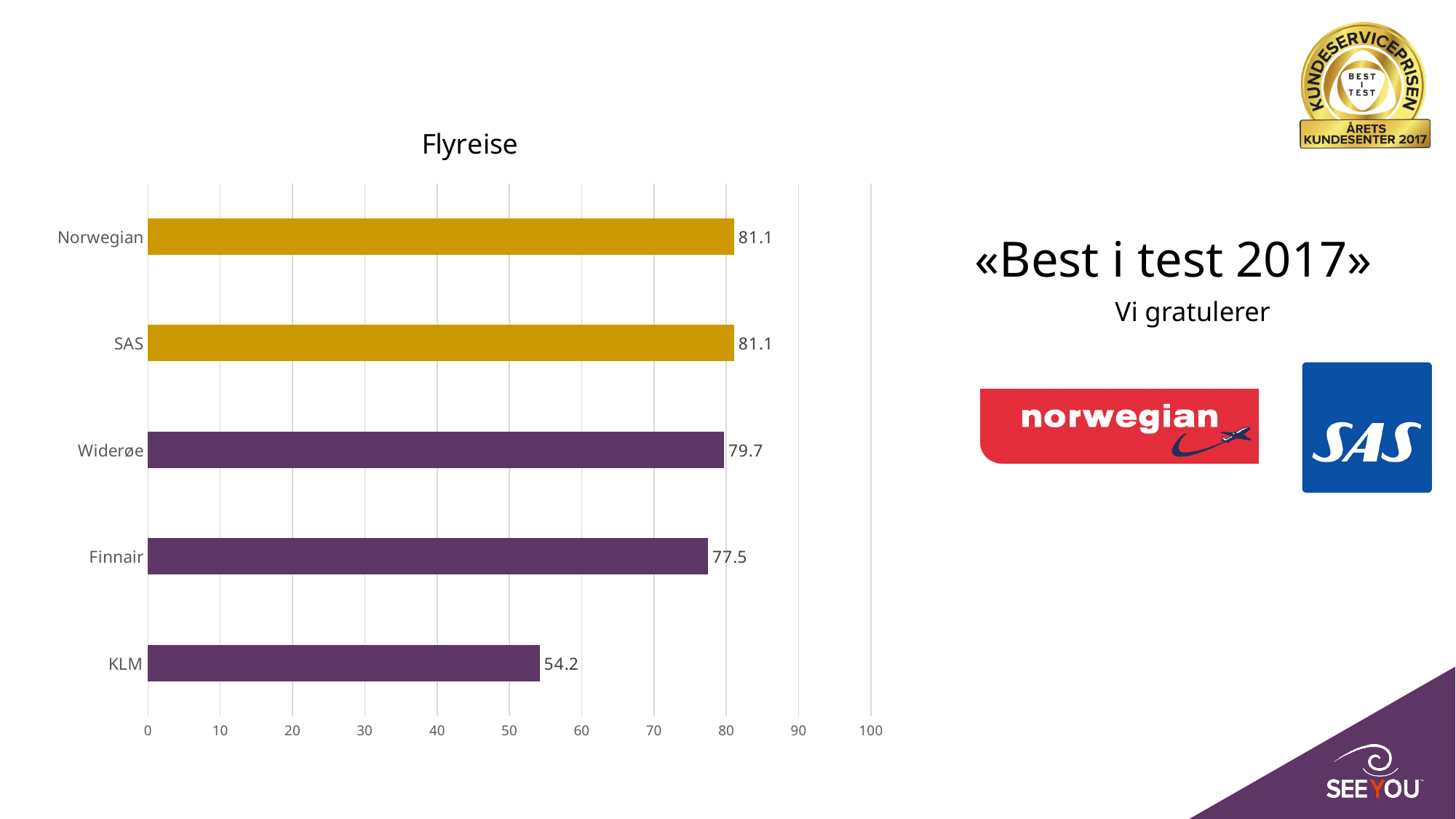
How many categories are shown in the chart? 5 What is the title of the chart? Flyreise What kind of chart is shown on the slide? bar chart Is the value for KLM greater or less than 60? less What is the value for KLM? 54.2 What is the value for Widerøe? 79.7 Which category has the lowest value? KLM What is the value for Finnair? 77.5 Which is larger, the value for Widerøe or the value for KLM? Widerøe What is the value for Norwegian? 81.1 What is the difference between the values for Finnair and KLM? 23.3 What is the difference between the values for SAS and Widerøe? 1.4